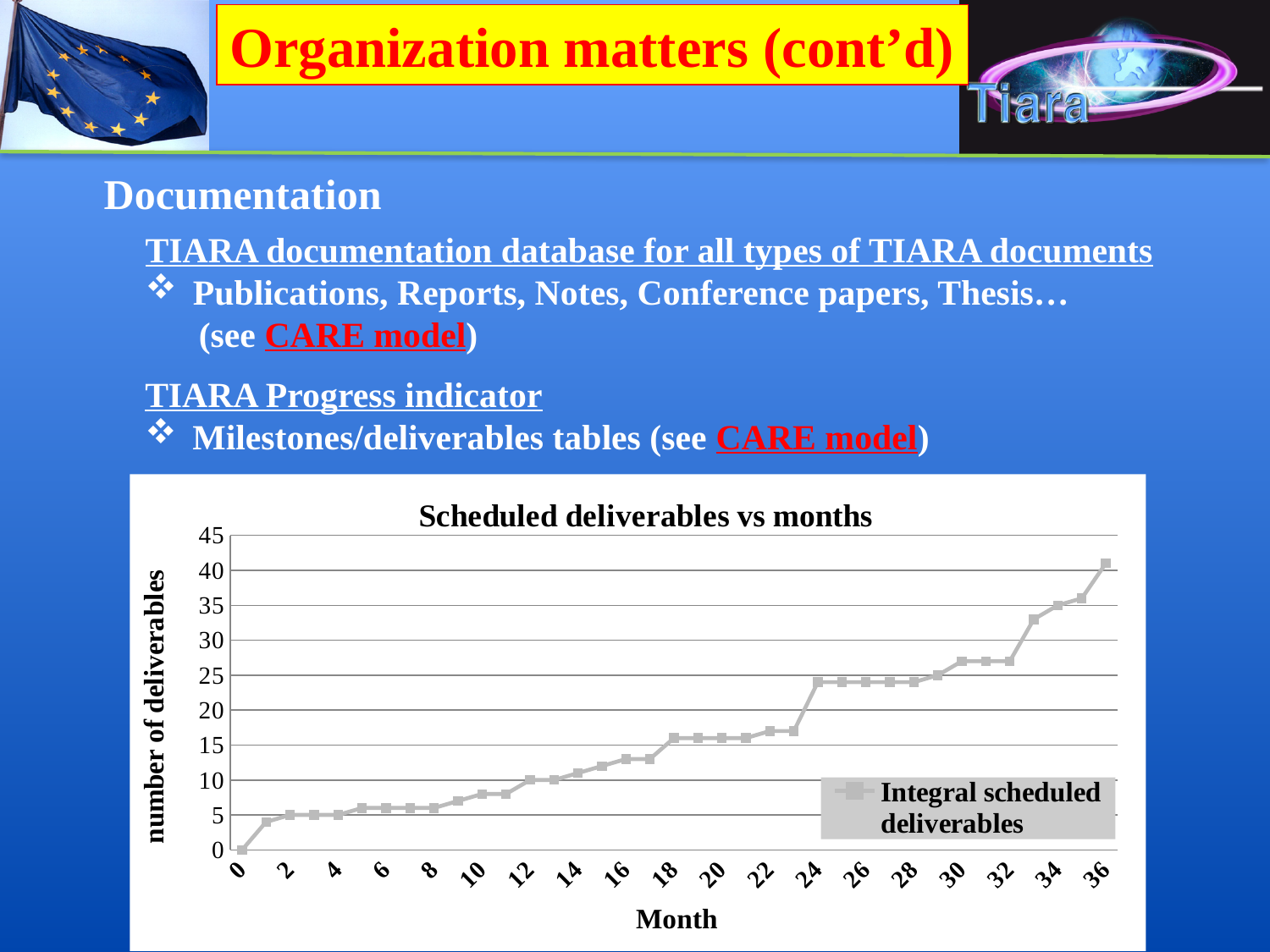
What is the number of deliverables at month 0? 0 Do the values rise or fall as the month increases along the x axis? rise What kind of chart is shown on the slide? line chart Is the number of deliverables at month 24 greater or less than 20? greater Is the number of deliverables at month 36 greater or less than 40? greater What is the name of the series shown in the legend? Integral scheduled deliverables What is the title of the chart? Scheduled deliverables vs months At which month is the number of deliverables lowest? 0 At which month is the number of deliverables highest? 36 What is the number of deliverables at month 12? 10 Which month has more scheduled deliverables, month 18 or month 30? 30 How many series does the chart legend list? 1